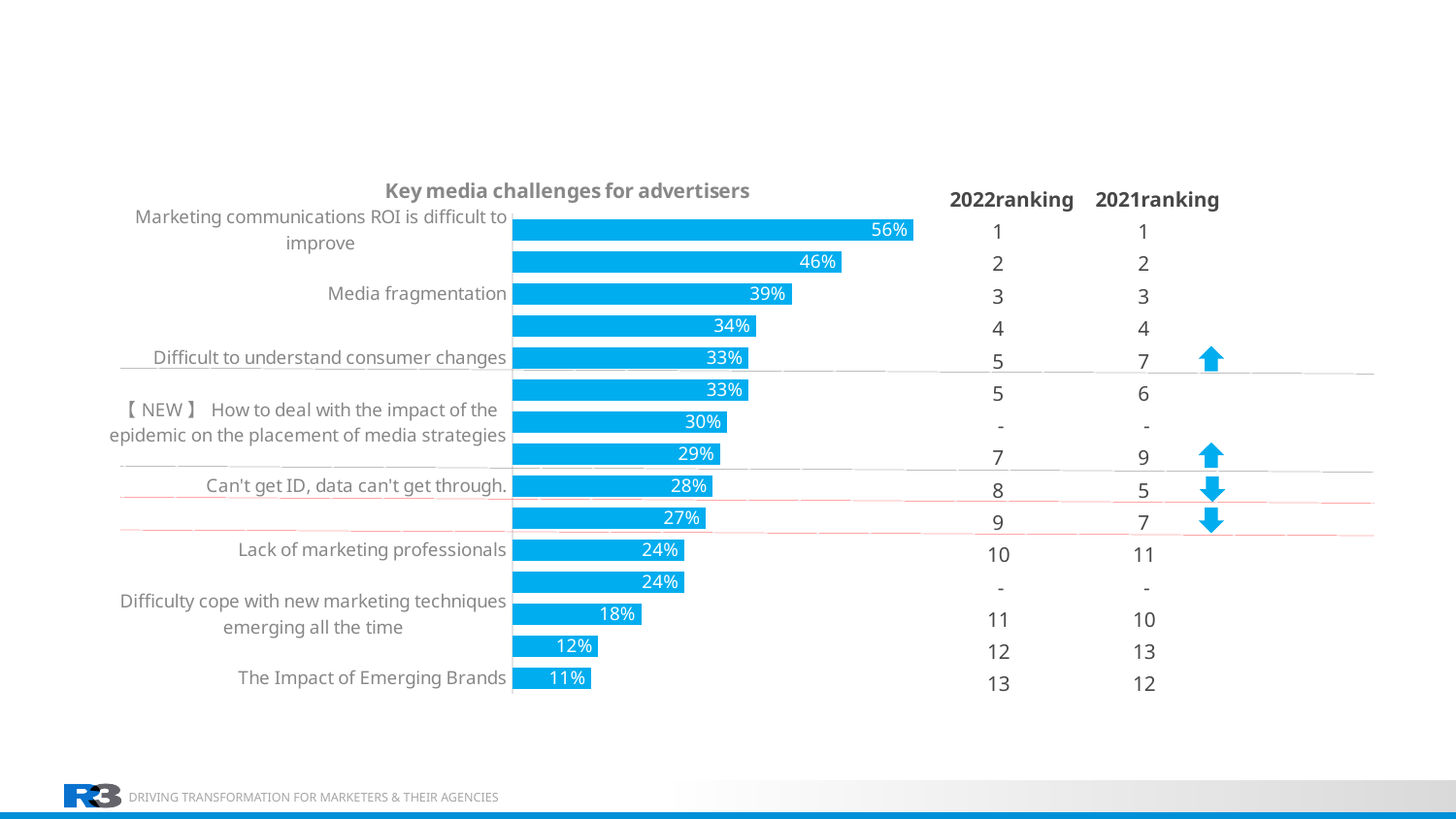
Which challenge has the lowest value in the chart? The Impact of Emerging Brands What is the value for "Lack of marketing professionals"? 24% What is the title of the chart? Key media challenges for advertisers What is the value for "Can't get ID, data can't get through."? 28% Which has a larger value, "Media fragmentation" or "Can't get ID, data can't get through."? Media fragmentation What is the difference between the values for "Marketing communications ROI is difficult to improve" and "Media fragmentation"? 17 percentage points Which challenge has the highest value in the chart? Marketing communications ROI is difficult to improve What is the value for "Media fragmentation"? 39% What is the value for "Difficult to understand consumer changes"? 33% What is the value for "Marketing communications ROI is difficult to improve"? 56% What is the value for "The Impact of Emerging Brands"? 11% What kind of chart is shown on the slide? Bar chart